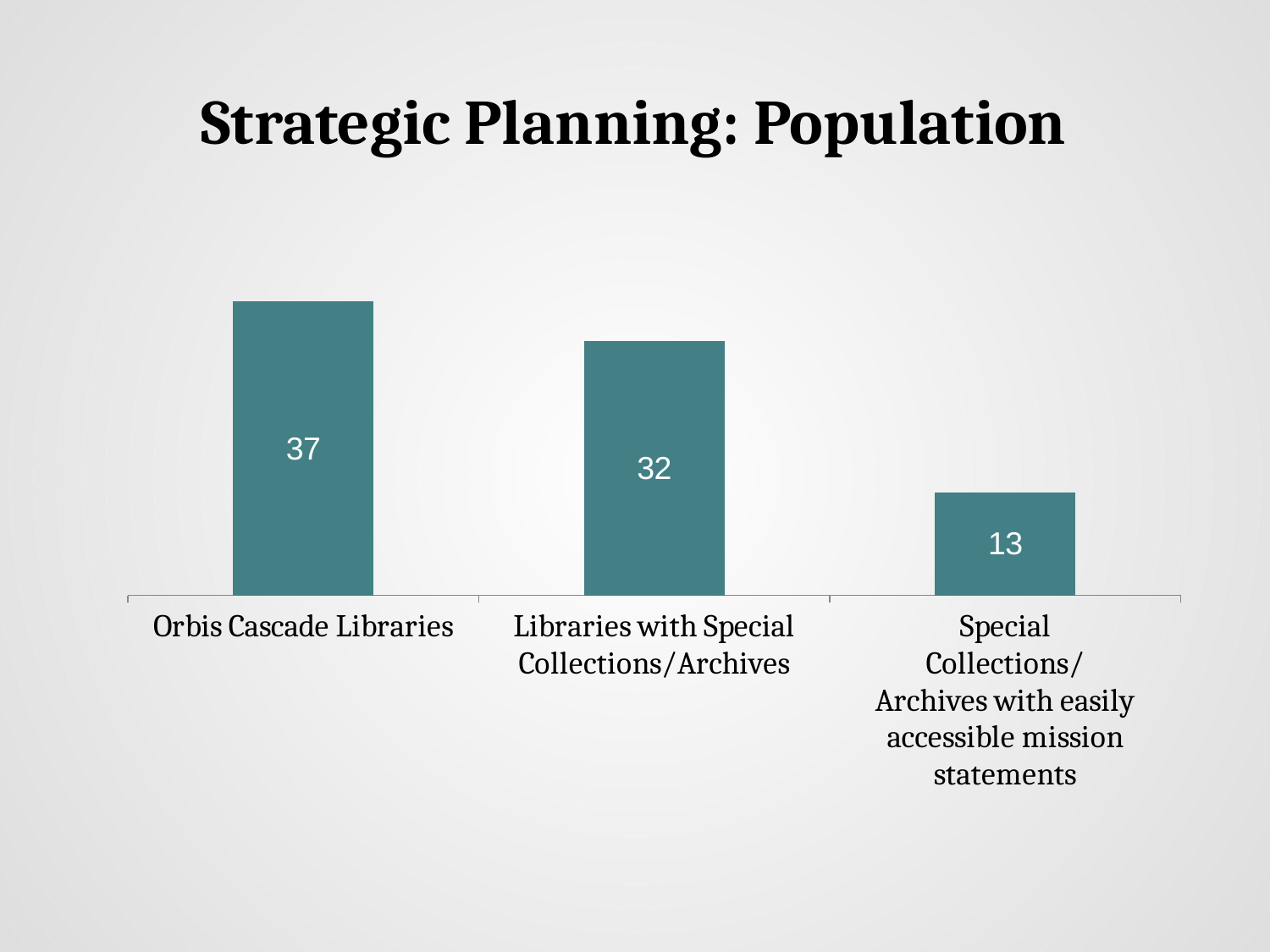
Which is larger: the value for Libraries with Special Collections/Archives or the value for Special Collections/Archives with easily accessible mission statements? Libraries with Special Collections/Archives What kind of chart is shown on the slide? Bar chart What is the difference between the values for Libraries with Special Collections/Archives and Special Collections/Archives with easily accessible mission statements? 19 How many categories are shown in the chart? 3 What is the value for Orbis Cascade Libraries? 37 What is the value for Special Collections/Archives with easily accessible mission statements? 13 What is the value for Libraries with Special Collections/Archives? 32 Which category has the highest value? Orbis Cascade Libraries Do the values rise or fall from left to right across the categories? Fall What is the title of the slide? Strategic Planning: Population Which category has the lowest value? Special Collections/Archives with easily accessible mission statements What is the difference between the values for Orbis Cascade Libraries and Libraries with Special Collections/Archives? 5